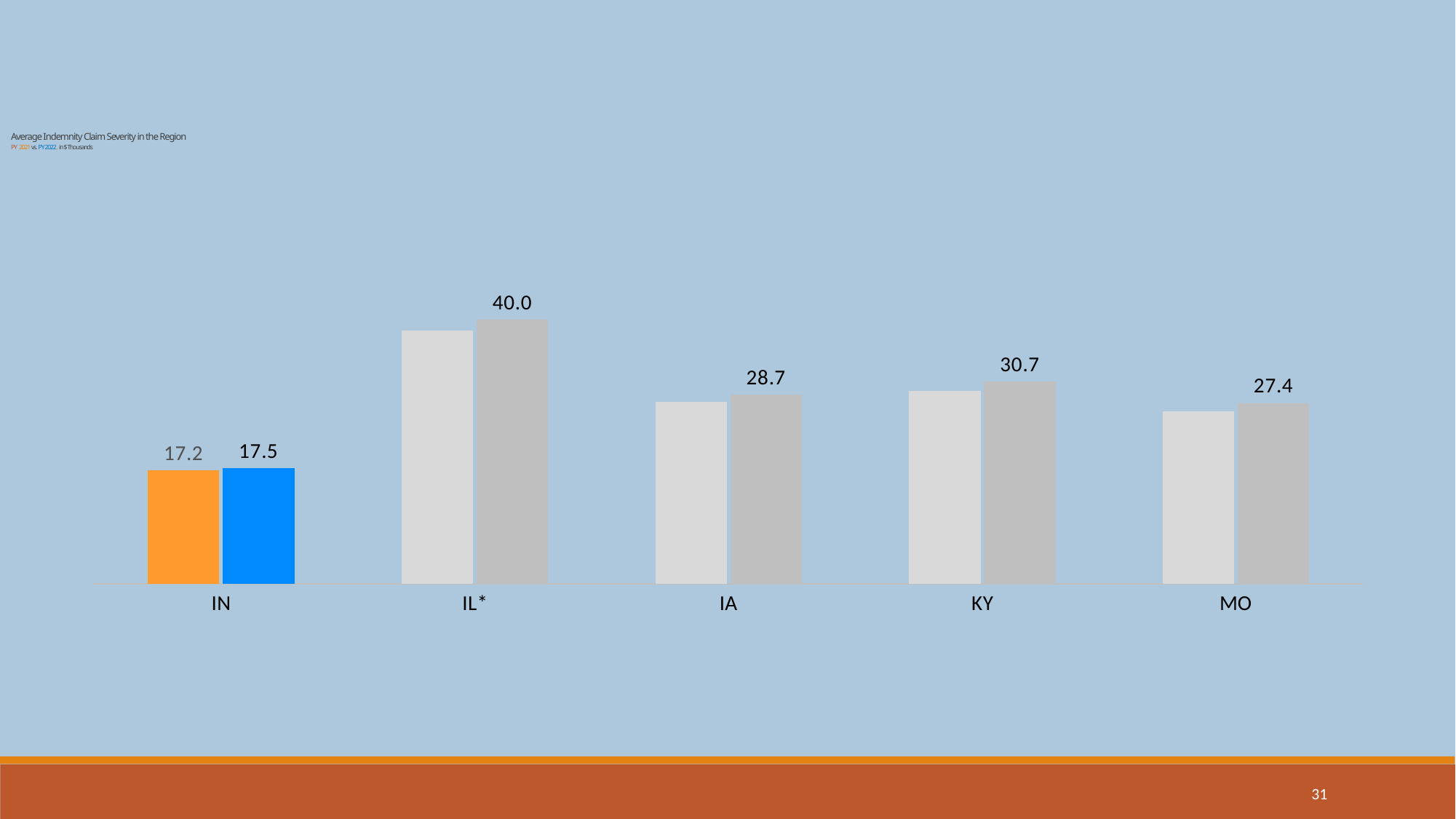
What is the PY 2022 value shown for KY? 30.7 What is the PY 2022 value shown for MO? 27.4 What is the PY 2022 average indemnity claim severity for IN? 17.5 How many states are shown on the x axis of the chart? 5 Which state has the lowest PY 2022 average indemnity claim severity? IN By how much did the average indemnity claim severity for IN increase from PY 2021 to PY 2022? 0.3 What is the difference between the PY 2022 values for KY and IA? 2.0 Which state has the highest PY 2022 average indemnity claim severity? IL* What is the PY 2022 value shown for IA? 28.7 What is the PY 2022 value shown for IL*? 40.0 What is the PY 2021 average indemnity claim severity for IN? 17.2 What kind of chart is shown on the slide? Bar chart